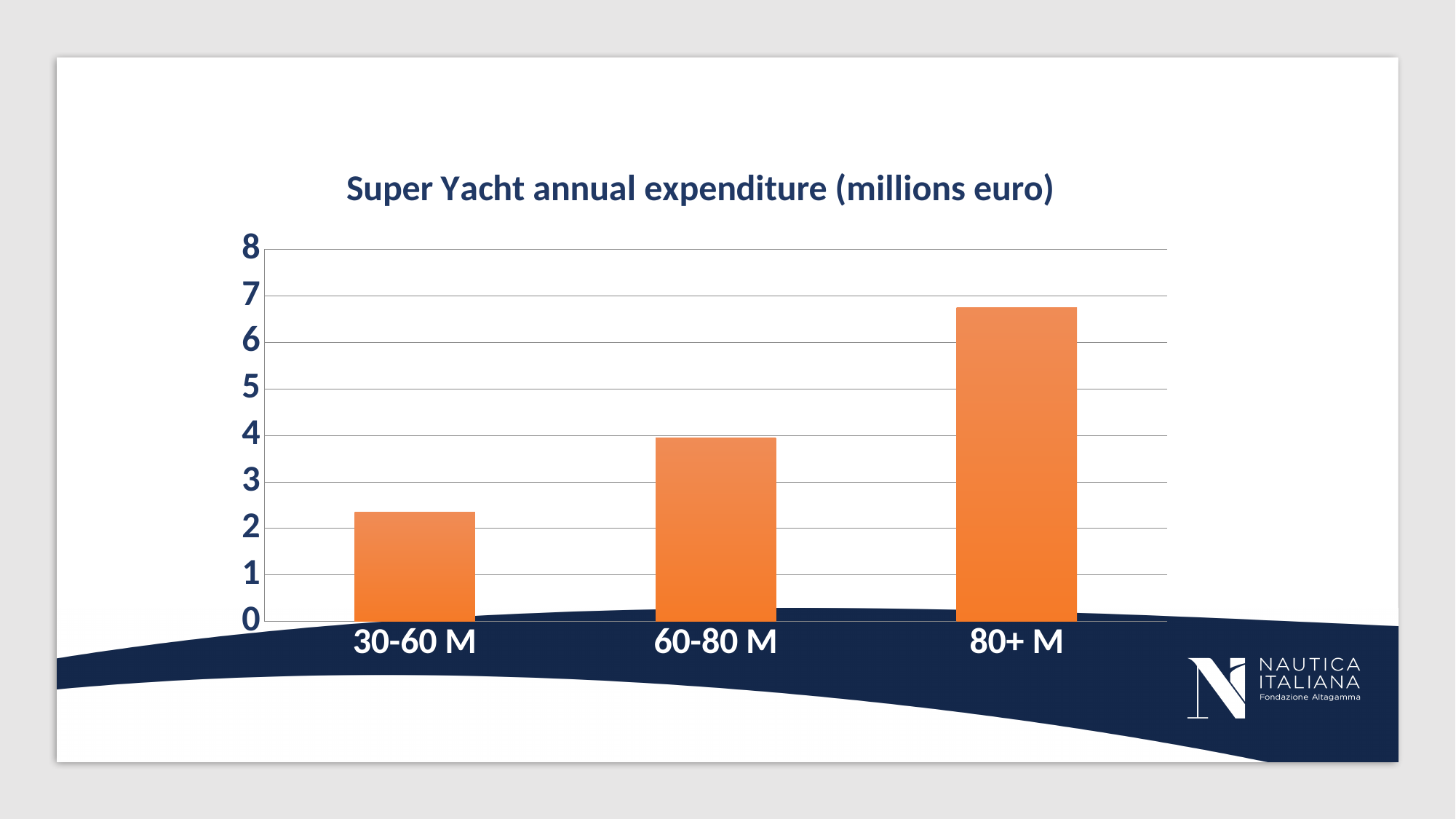
What kind of chart is shown on the slide? bar chart Do the values rise or fall moving from 30-60 M to 80+ M along the x axis? rise Is the value for 30-60 M greater or less than 2? greater Which category has the lowest annual expenditure? 30-60 M Which is larger, the value for 60-80 M or the value for 30-60 M? 60-80 M How many categories are shown on the x axis of the chart? 3 Which category has the highest annual expenditure? 80+ M Is the value for 60-80 M greater or less than 3? greater Which is larger, the value for 80+ M or the value for 60-80 M? 80+ M What is the title of the chart? Super Yacht annual expenditure (millions euro) Is the value for 80+ M greater or less than 6? greater